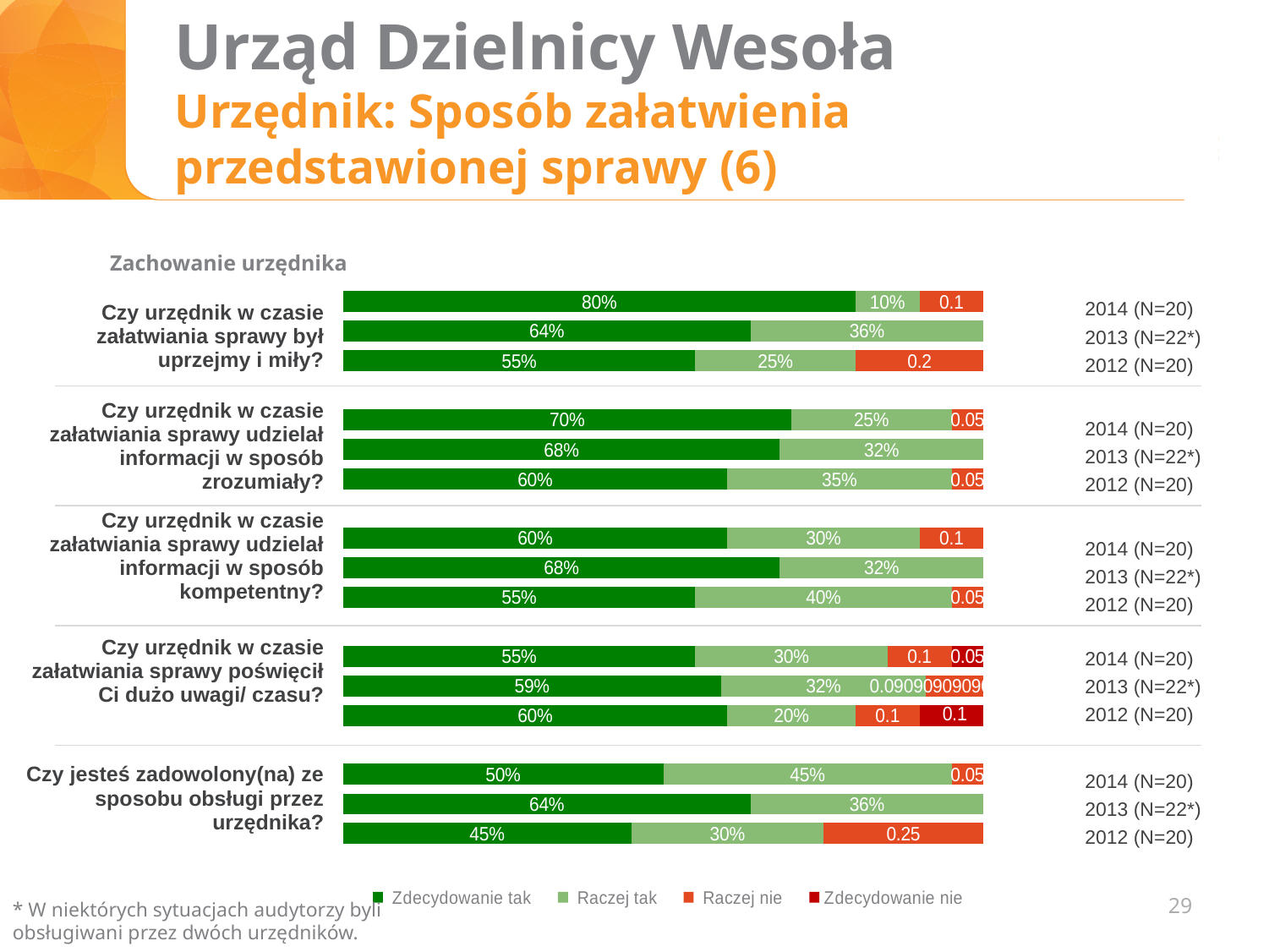
For the question "Czy jesteś zadowolony(na) ze sposobu obsługi przez urzędnika?", which year has the lowest "Zdecydowanie tak" share? 2012 (N=20) For the question "Czy jesteś zadowolony(na) ze sposobu obsługi przez urzędnika?", which year has the larger "Raczej tak" share, 2014 or 2012? 2014 What is the "Raczej tak" value for 2012 for the question "Czy urzędnik w czasie załatwiania sprawy udzielał informacji w sposób kompetentny?"? 40% For the question "Czy urzędnik w czasie załatwiania sprawy był uprzejmy i miły?", which year has the highest "Zdecydowanie tak" share? 2014 (N=20) How many years (bars) are shown for each question in the chart? 3 What percentage answered "Zdecydowanie tak" in 2014 to the question "Czy urzędnik w czasie załatwiania sprawy był uprzejmy i miły?"? 80% What value is printed on the "Raczej nie" segment for 2012 for the question "Czy urzędnik w czasie załatwiania sprawy był uprzejmy i miły?"? 0.2 For the question "Czy urzędnik w czasie załatwiania sprawy był uprzejmy i miły?", by how many percentage points does the 2014 "Zdecydowanie tak" share exceed the 2012 share? 25 percentage points How many series does the legend list? 4 What kind of chart is shown on the slide? Stacked bar chart What is the "Raczej tak" value for 2013 for the question "Czy urzędnik w czasie załatwiania sprawy był uprzejmy i miły?"? 36% What is the "Zdecydowanie tak" value for 2012 for the question "Czy jesteś zadowolony(na) ze sposobu obsługi przez urzędnika?"? 45%